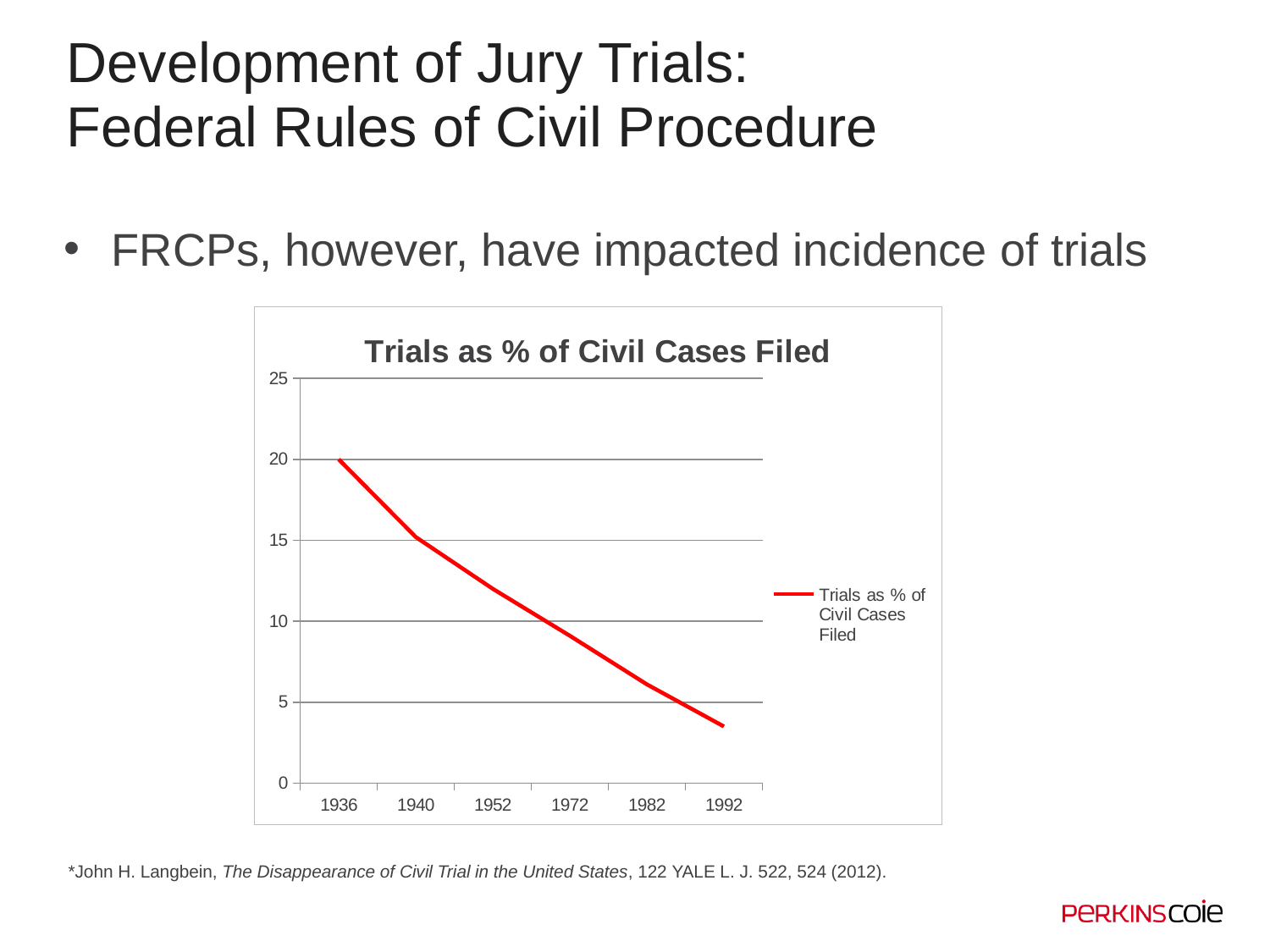
Which year has the highest value for trials as % of civil cases filed? 1936 Is the value for 1952 greater or less than 10? greater What kind of chart is shown on the slide? line chart How many years are plotted along the x axis of the chart? 6 What colour is the line in the chart? red Is the value for 1992 greater or less than 5? less How many series does the chart's legend list? 1 Which year has the lowest value for trials as % of civil cases filed? 1992 What is the title of the chart? Trials as % of Civil Cases Filed What is the value for trials as % of civil cases filed in 1936? 20 Which year has the larger value, 1940 or 1982? 1940 Do the values rise or fall from 1936 to 1992? fall